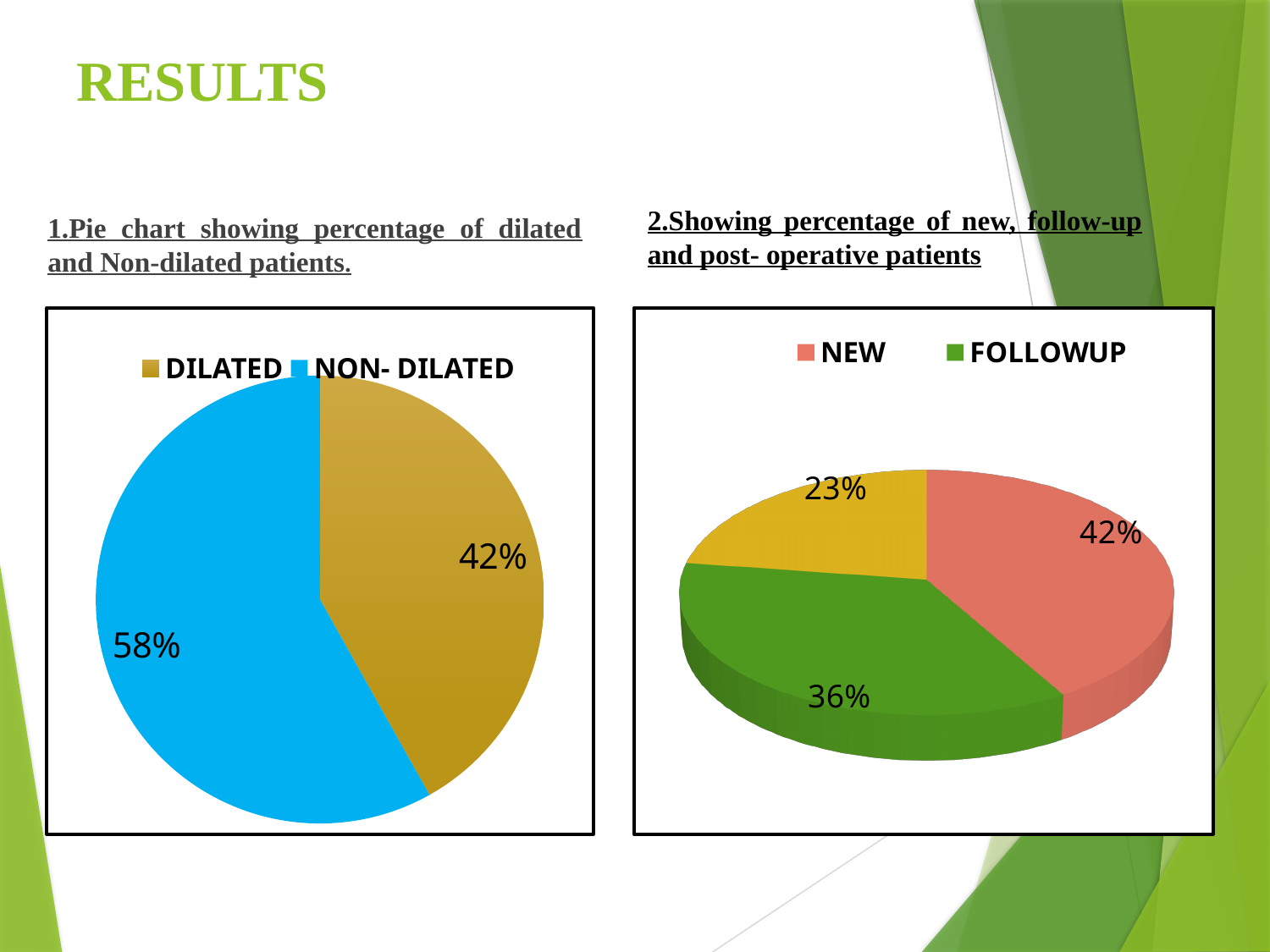
In the left pie chart (dilated and non-dilated patients), what colour is the DILATED slice? Gold In the right pie chart (new, follow-up and post-operative patients), which is larger, NEW or FOLLOWUP? NEW In the right pie chart (new, follow-up and post-operative patients), how many entries are visible in the legend? 2 What type of chart is the chart on the right (new, follow-up and post-operative patients)? Pie chart In the left pie chart (dilated and non-dilated patients), how many slices does the pie have? 2 In the left pie chart (dilated and non-dilated patients), what percentage of patients are non-dilated? 58% In the right pie chart (new, follow-up and post-operative patients), what percentage of patients are NEW? 42% In the right pie chart (new, follow-up and post-operative patients), how many slices does the pie have? 3 In the right pie chart (new, follow-up and post-operative patients), what percentage of patients are FOLLOWUP? 36% In the left pie chart (dilated and non-dilated patients), which category has the larger share? NON- DILATED In the left pie chart (dilated and non-dilated patients), what is the difference in percentage points between non-dilated and dilated patients? 16 In the left pie chart (dilated and non-dilated patients), what percentage of patients are dilated? 42%